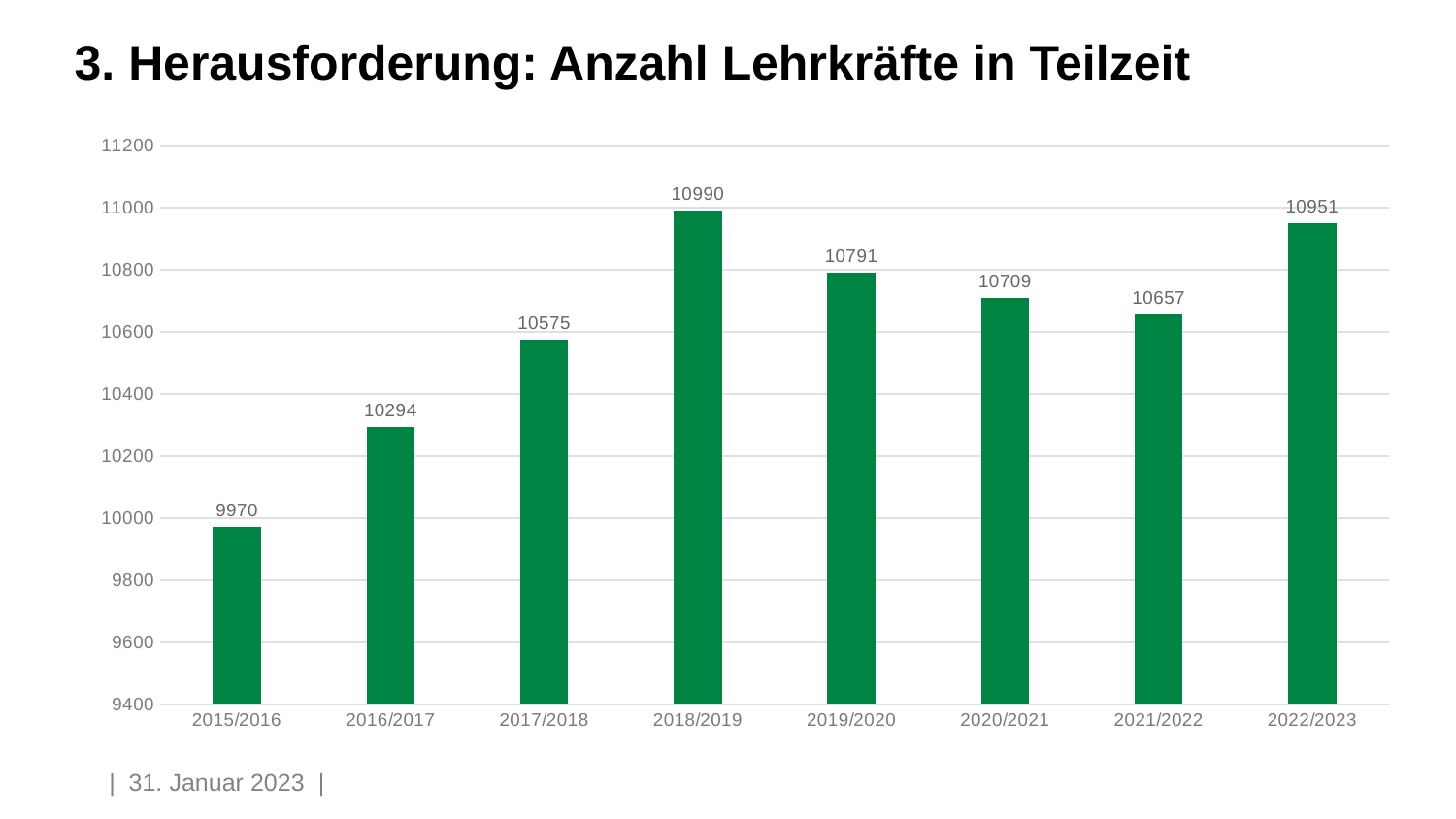
How many school years are shown on the x axis? 8 Which is larger, the value for 2017/2018 or the value for 2020/2021? 2020/2021 Is the value for 2016/2017 greater or less than 10400? less What is the title of the slide? 3. Herausforderung: Anzahl Lehrkräfte in Teilzeit What is the value for 2015/2016? 9970 What is the difference between the values for 2022/2023 and 2015/2016? 981 What is the value for 2021/2022? 10657 What is the difference between the values for 2018/2019 and 2019/2020? 199 What is the value for 2018/2019? 10990 Which school year has the highest value? 2018/2019 What kind of chart is shown on the slide? bar chart Which school year has the lowest value? 2015/2016